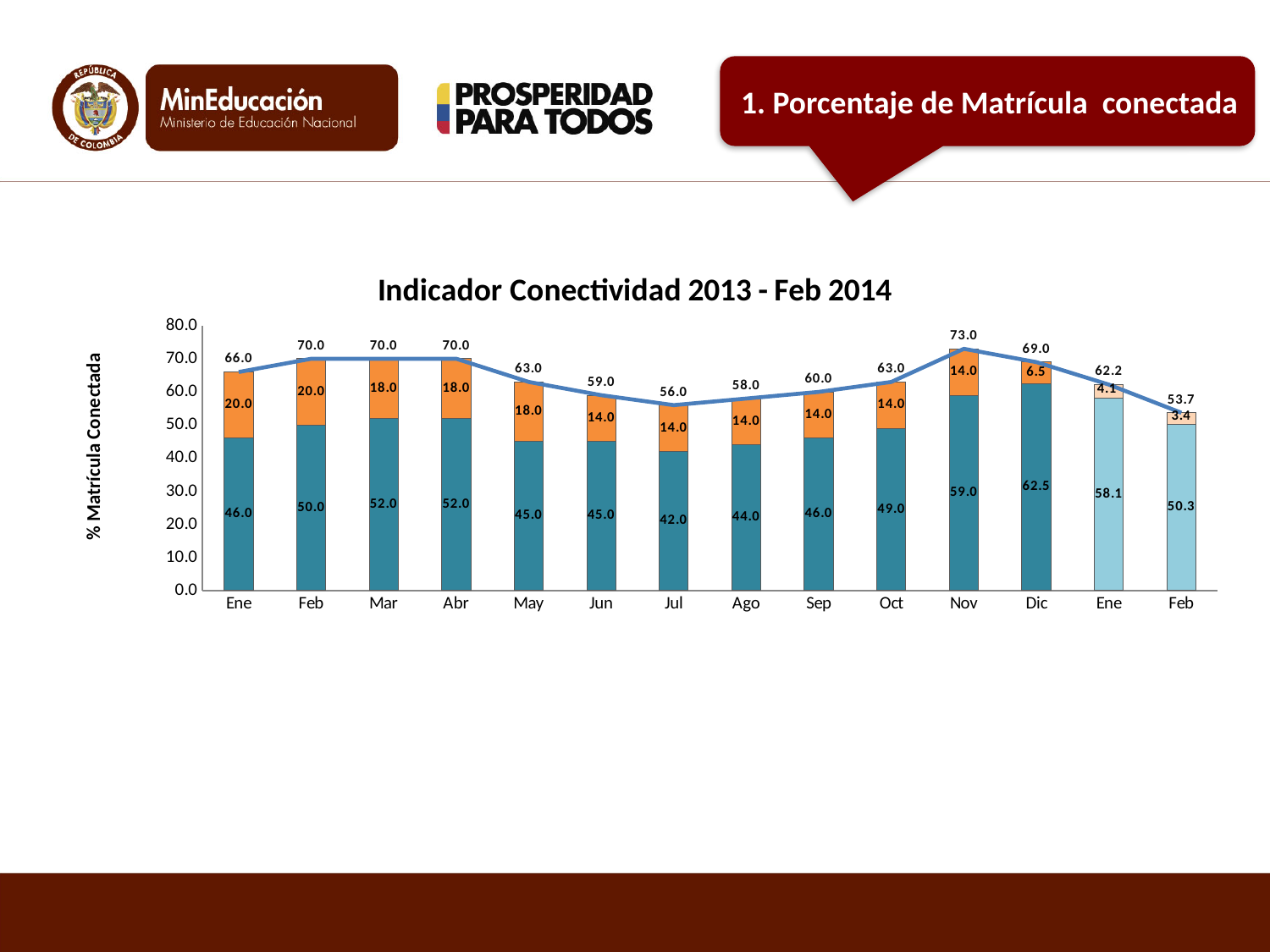
How many months (categories) are shown on the x axis of the chart? 14 What type of chart is shown on the slide? Stacked bar chart with a line What is the title of the chart? Indicador Conectividad 2013 - Feb 2014 Which month has the lowest total value on the line? Feb (2014, last bar) What is the value of the bottom (dark) segment of the bar for Dic? 62.5 What is the total value shown above the last bar (Feb 2014)? 53.7 What is the difference between the total for Nov (73.0) and the total for Jul (56.0)? 17.0 What is the value of the top (orange) segment of the bar for Mar? 18.0 What is the total value shown above the bar for Nov? 73.0 Which month has the highest total value on the line? Nov What is the label on the vertical axis of the chart? % Matrícula Conectada Which is larger, the bottom segment for Oct or the bottom segment for Sep? Oct